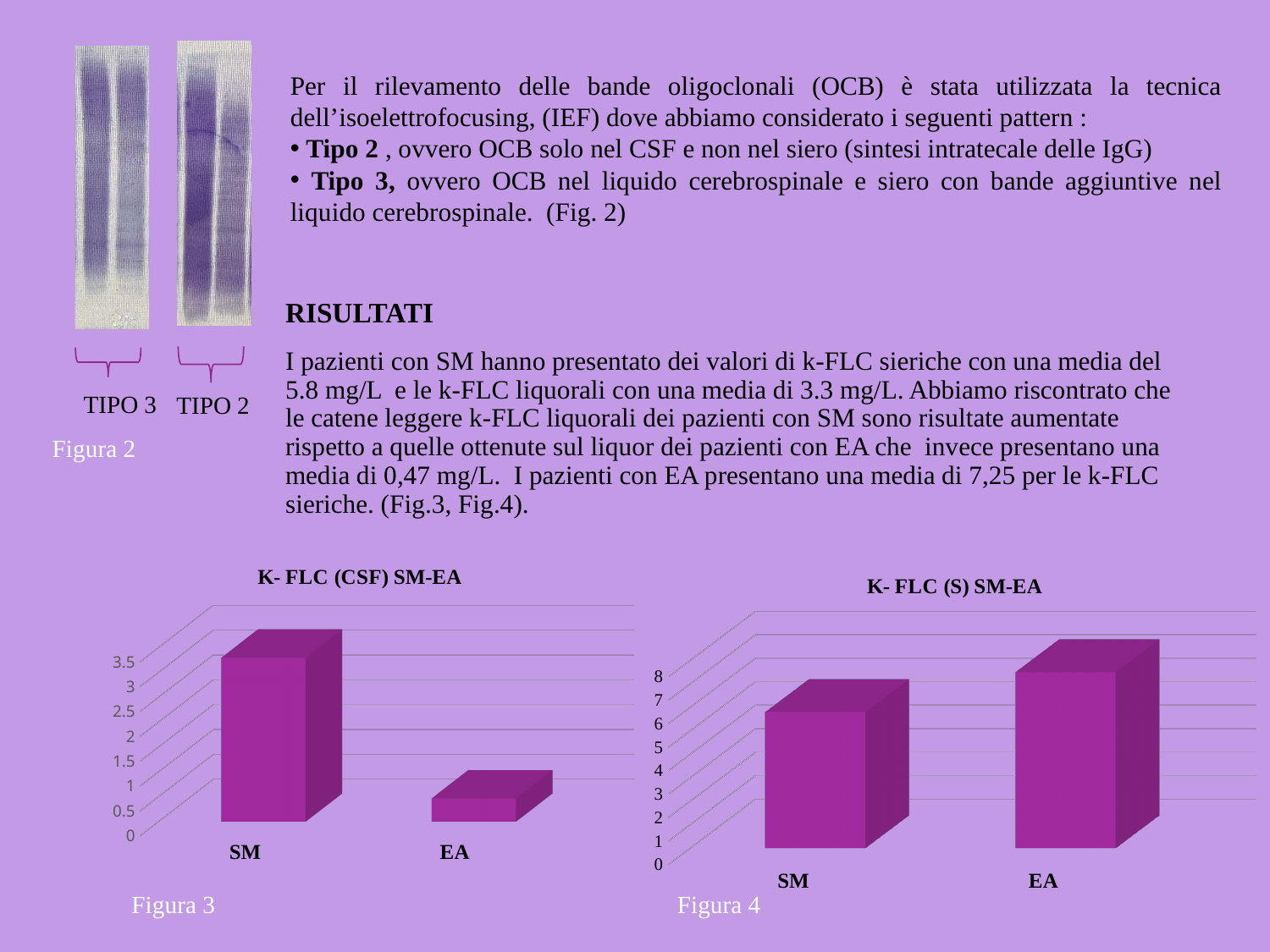
In the "K- FLC (S) SM-EA" chart, which category has the lowest bar? SM What kind of chart is the "K- FLC (CSF) SM-EA" chart (Figura 3)? bar chart In the "K- FLC (CSF) SM-EA" chart, which category has the lowest bar? EA In the "K- FLC (CSF) SM-EA" chart, which category has the highest bar? SM In the "K- FLC (CSF) SM-EA" chart, is the value for EA greater or less than 1? less In the "K- FLC (S) SM-EA" chart, which category has the highest bar? EA What kind of chart is the "K- FLC (S) SM-EA" chart (Figura 4)? bar chart In the "K- FLC (S) SM-EA" chart, is the value for SM greater or less than 5? greater What is the title of the chart labelled Figura 4? K- FLC (S) SM-EA In the "K- FLC (CSF) SM-EA" chart, is the value for SM greater or less than 3? greater How many categories are shown on the x axis of the "K- FLC (CSF) SM-EA" chart? 2